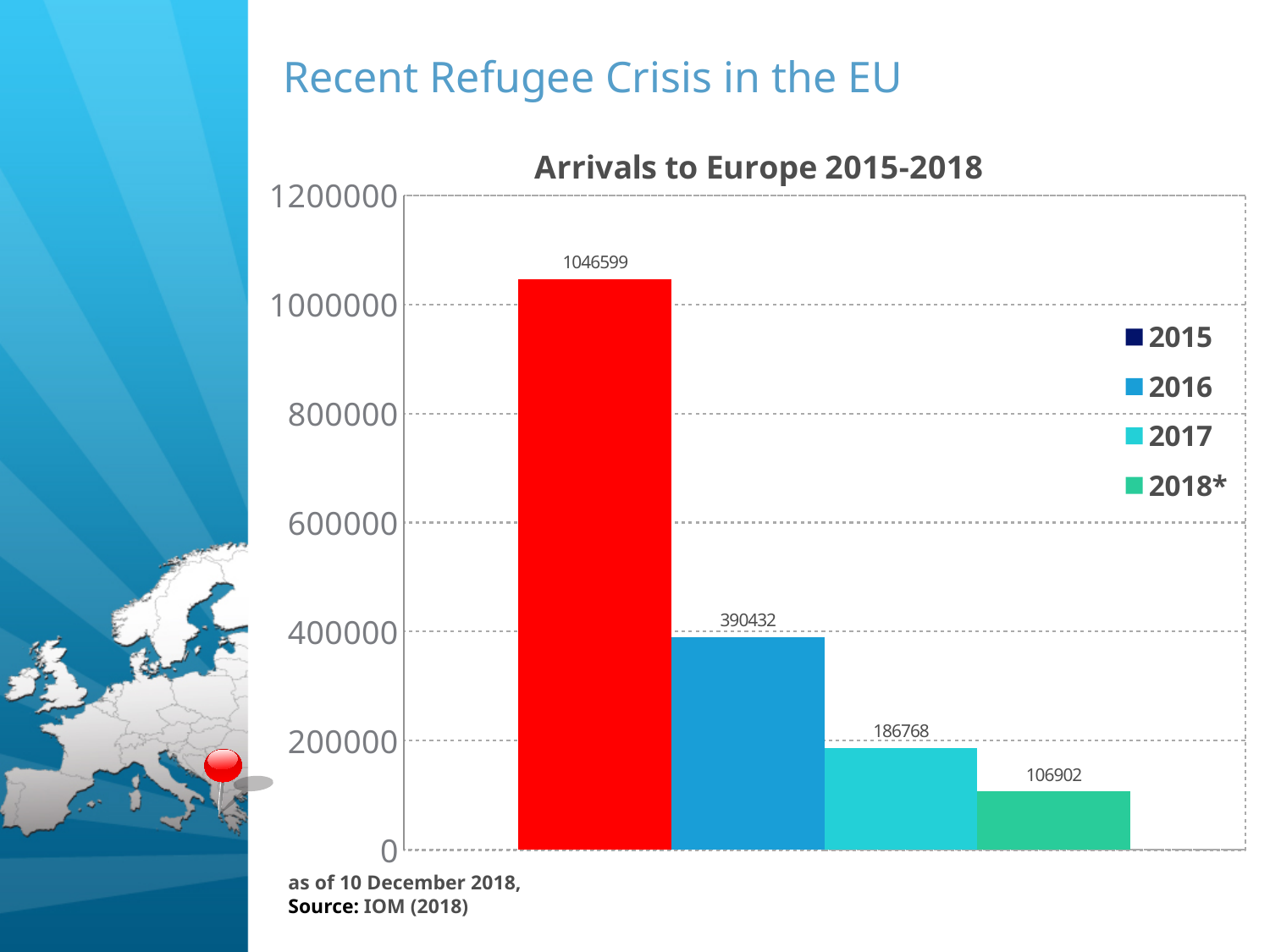
What is the value for 2016 in the Arrivals to Europe 2015-2018 chart? 390432 How many years (bars) are plotted in the Arrivals to Europe 2015-2018 chart? 4 What is the value for 2015 in the Arrivals to Europe 2015-2018 chart? 1046599 What kind of chart is shown on the slide? Bar chart Which year has the lowest number of arrivals in the chart? 2018* What is the difference between the 2015 and 2016 values in the chart? 656167 Which is larger in the chart, the value for 2016 or the value for 2017? 2016 Do the values rise or fall from 2015 to 2018* in the chart? Fall What is the value for 2018* in the Arrivals to Europe 2015-2018 chart? 106902 What is the value for 2017 in the Arrivals to Europe 2015-2018 chart? 186768 Which year has the highest number of arrivals in the chart? 2015 What is the difference between the 2017 and 2018* values in the chart? 79866